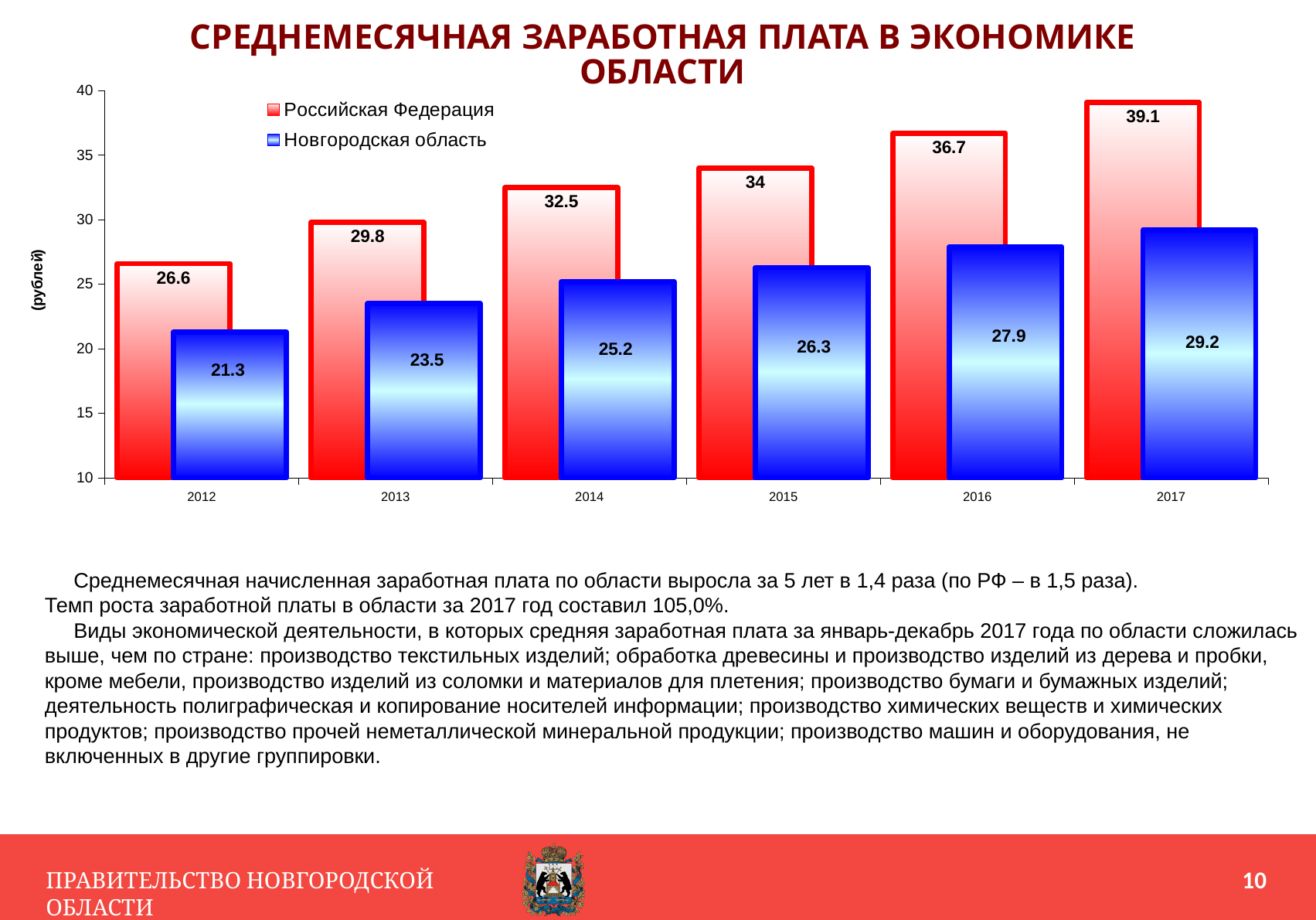
How many years are shown on the x axis? 6 Is the value for Новгородская область in 2013 greater or less than 25? less How many series does the legend list? 2 In which year was the value for Новгородская область highest? 2017 Do the values for Новгородская область rise or fall from 2012 to 2017? rise What was the value for Российская Федерация in 2012? 26.6 What was the value for Российская Федерация in 2014? 32.5 What kind of chart is shown on the slide? bar chart In which year was the value for Российская Федерация lowest? 2012 Which is larger in 2015: Российская Федерация or Новгородская область? Российская Федерация What is the difference between Российская Федерация and Новгородская область in 2017? 9.9 What was the value for Новгородская область in 2016? 27.9